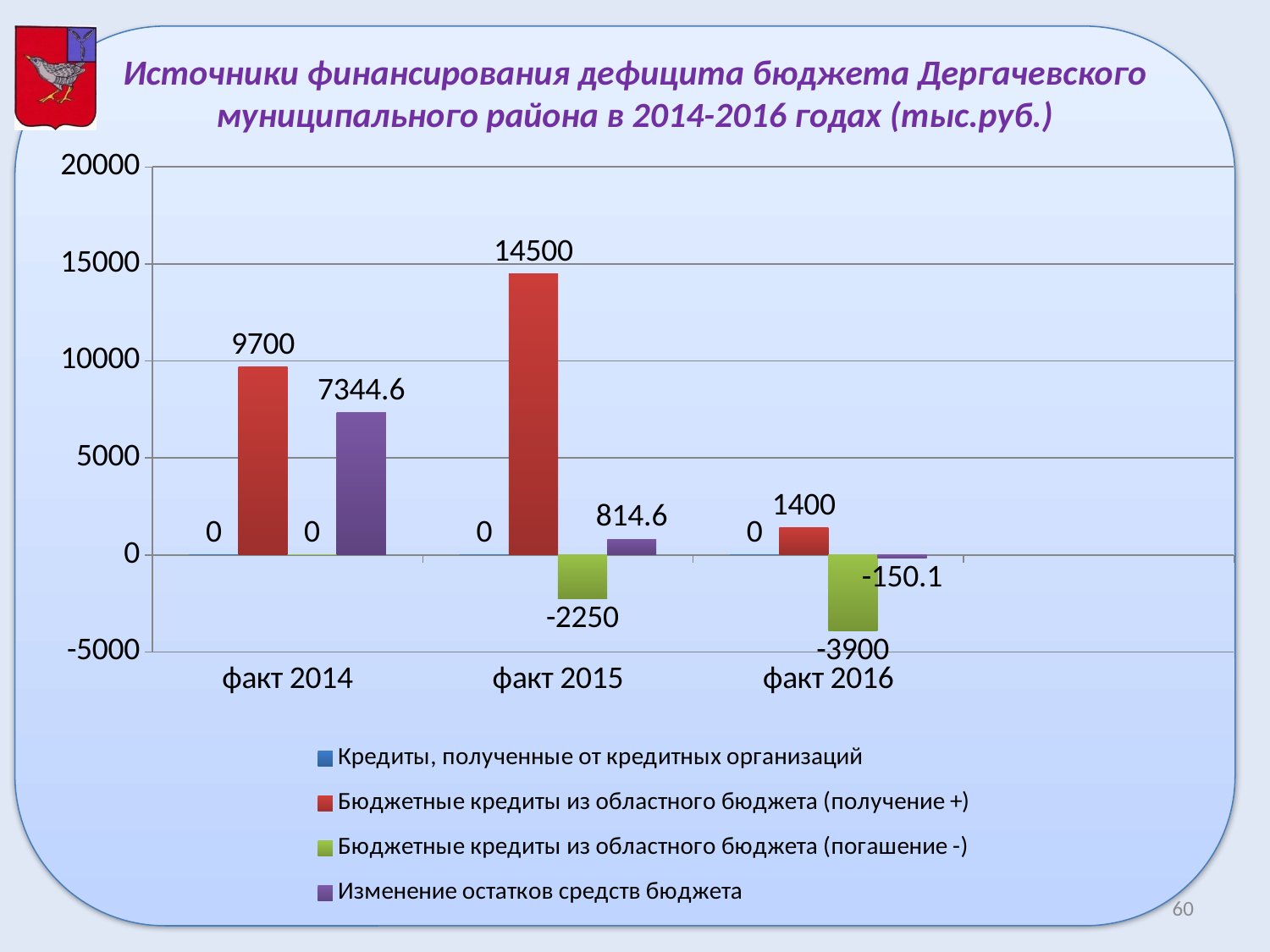
In which year is 'Бюджетные кредиты из областного бюджета (получение +)' highest? факт 2015 What is the difference between 'Бюджетные кредиты из областного бюджета (получение +)' in факт 2015 and факт 2014? 4800 How many categories are shown on the x axis? 3 What is the value of 'Бюджетные кредиты из областного бюджета (получение +)' for факт 2015? 14500 What is the value of 'Изменение остатков средств бюджета' for факт 2016? -150.1 How does 'Бюджетные кредиты из областного бюджета (погашение -)' change from факт 2015 to факт 2016? falls How many series does the legend list? 4 Which is larger: 'Бюджетные кредиты из областного бюджета (получение +)' in факт 2014 or in факт 2016? факт 2014 What is the value of 'Изменение остатков средств бюджета' for факт 2014? 7344.6 What type of chart is shown on the slide? bar chart In which year is 'Изменение остатков средств бюджета' lowest? факт 2016 What is the value of 'Бюджетные кредиты из областного бюджета (погашение -)' for факт 2016? -3900